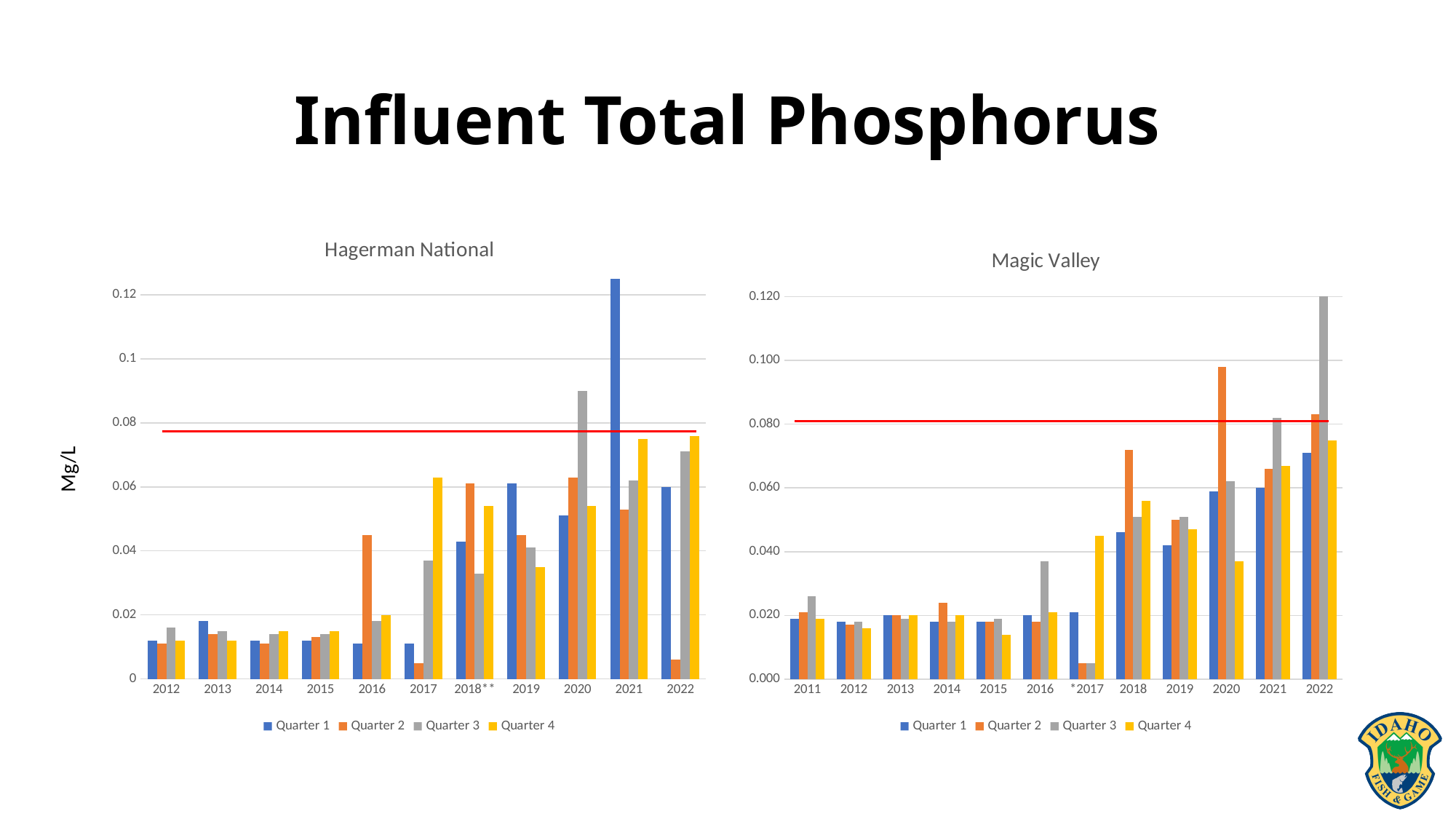
In the Hagerman National chart, is the Quarter 1 value for 2021 greater or less than 0.1? greater How many years are shown on the x axis of the Hagerman National chart? 11 In the Magic Valley chart, is the Quarter 2 value for 2018 greater or less than 0.080? less In the Magic Valley chart, which quarter has the tallest bar in 2022? Quarter 3 In the Magic Valley chart, which is larger in 2020: Quarter 2 or Quarter 4? Quarter 2 In the Magic Valley chart, is the Quarter 2 value for 2020 greater or less than 0.080? greater How many series does the legend of the Magic Valley chart list? 4 How many years are shown on the x axis of the Magic Valley chart? 12 What is the y-axis label on the Hagerman National chart? Mg/L In the Hagerman National chart, which year has the tallest bar? 2021 What type of chart is the Hagerman National chart? bar chart